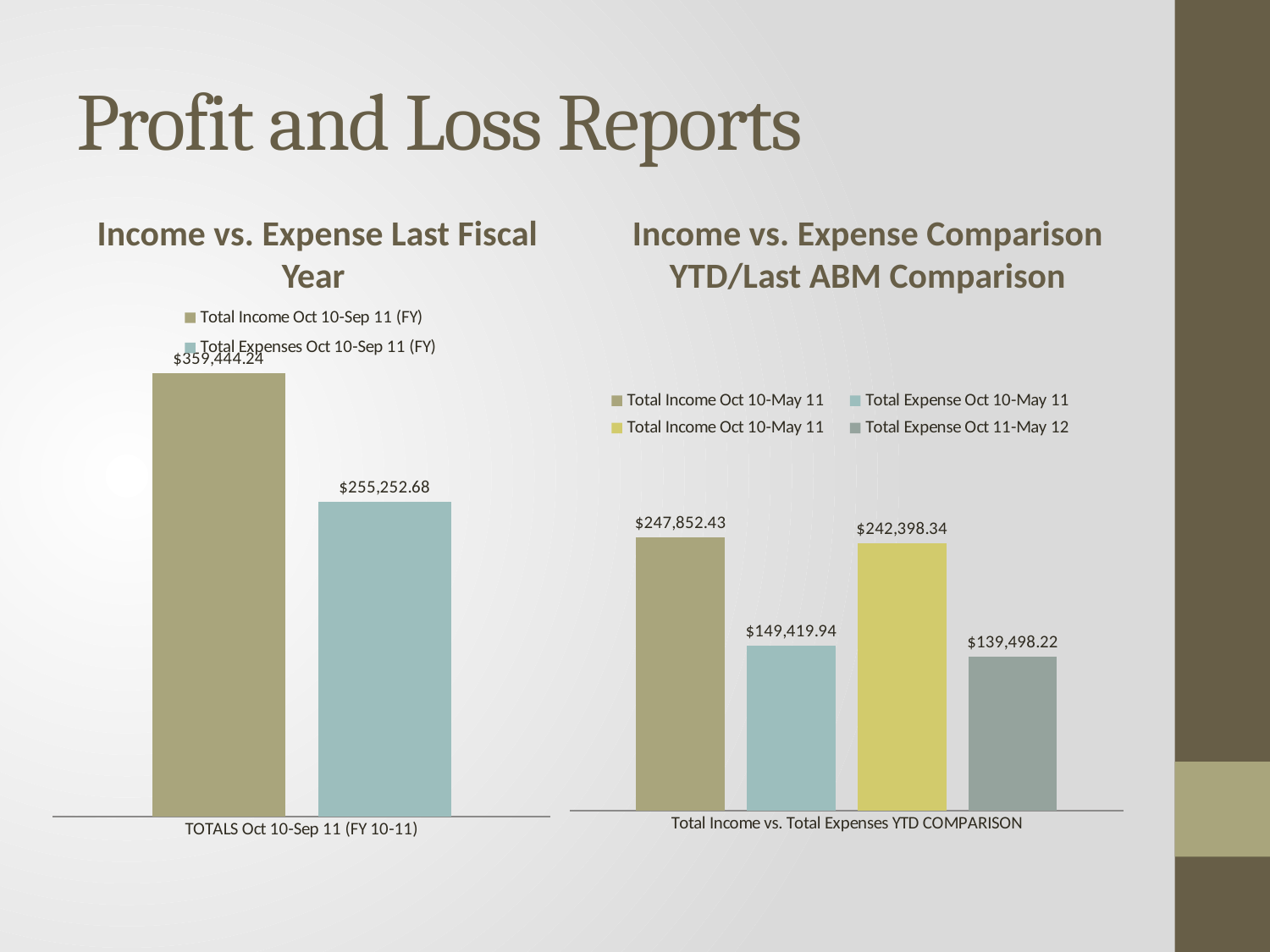
In the 'Income vs. Expense Comparison YTD/Last ABM Comparison' chart, how many bars are plotted? 4 In the 'Income vs. Expense Comparison YTD/Last ABM Comparison' chart, which bar has the lowest value? Total Expense Oct 11-May 12 In the 'Income vs. Expense Comparison YTD/Last ABM Comparison' chart, what is the value for Total Income Oct 10-May 11 (the first, leftmost bar)? $247,852.43 In the 'Income vs. Expense Comparison YTD/Last ABM Comparison' chart, what is the value for Total Expense Oct 11-May 12? $139,498.22 In the 'Income vs. Expense Comparison YTD/Last ABM Comparison' chart, what is the value of the yellow bar? $242,398.34 In the 'Income vs. Expense Comparison YTD/Last ABM Comparison' chart, what is the value for Total Expense Oct 10-May 11? $149,419.94 In the 'Income vs. Expense Last Fiscal Year' chart, how many series does the legend list? 2 What kind of chart is the 'Income vs. Expense Last Fiscal Year' chart? Bar chart In the 'Income vs. Expense Last Fiscal Year' chart, what is the value for Total Income Oct 10-Sep 11 (FY)? $359,444.24 In the 'Income vs. Expense Last Fiscal Year' chart, what is the difference between Total Income and Total Expenses? $104,191.56 In the 'Income vs. Expense Last Fiscal Year' chart, what is the value for Total Expenses Oct 10-Sep 11 (FY)? $255,252.68 In the 'Income vs. Expense Comparison YTD/Last ABM Comparison' chart, what is the difference between Total Expense Oct 10-May 11 and Total Expense Oct 11-May 12? $9,921.72